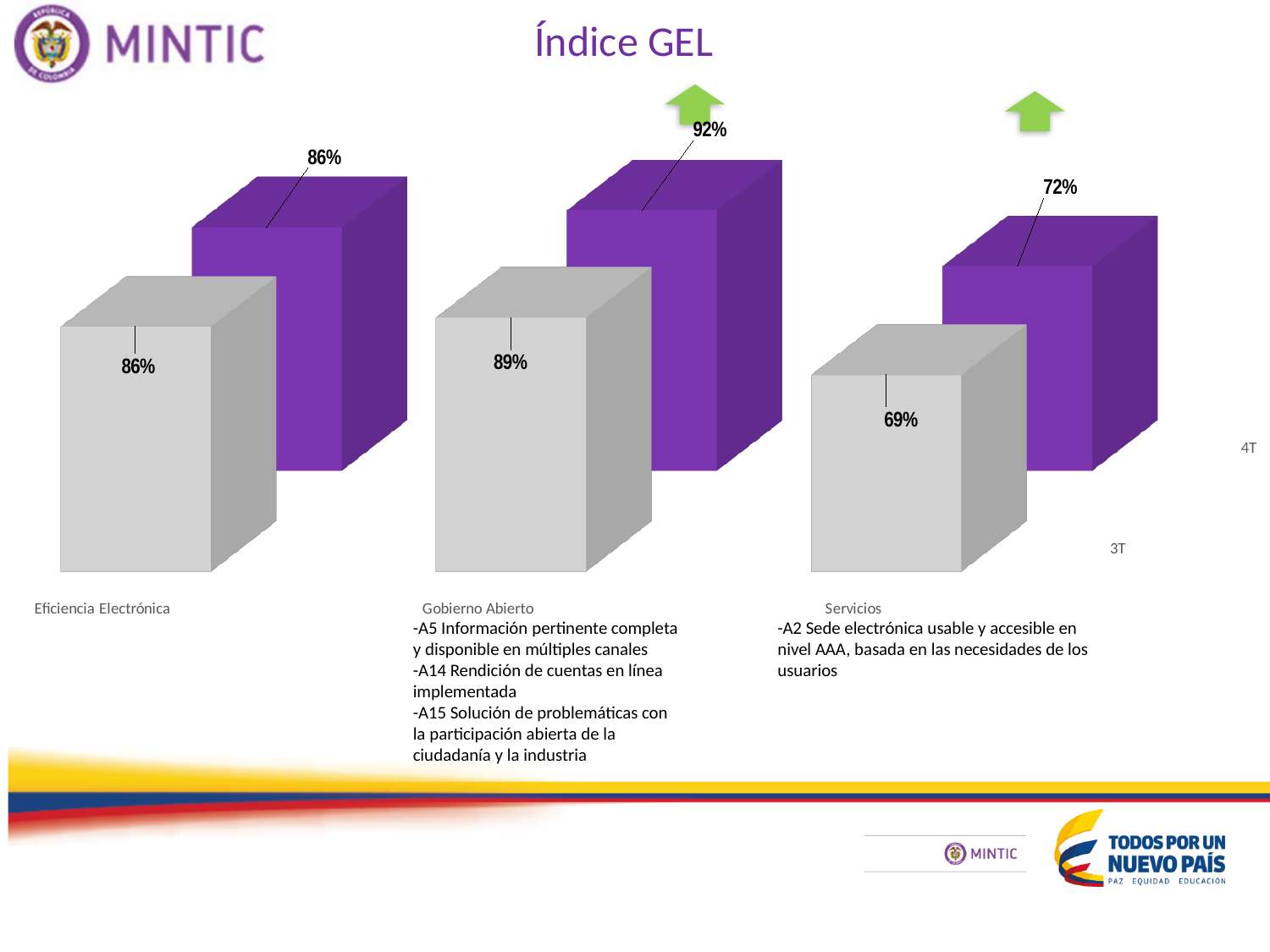
Which category has the highest 4T value? Gobierno Abierto What type of chart is shown on the slide? Bar chart What is the 4T value for Eficiencia Electrónica? 86% Which category has the lowest 3T value? Servicios What is the 3T value for Gobierno Abierto? 89% What is the difference between the 4T and 3T values for Gobierno Abierto? 3% Which is larger for Servicios, the 3T value or the 4T value? 4T How many categories are shown in the chart? 3 What is the 3T value for Servicios? 69% What is the 4T value for Servicios? 72% What is the difference between the 4T values for Gobierno Abierto and Servicios? 20% What is the title of the chart? Índice GEL